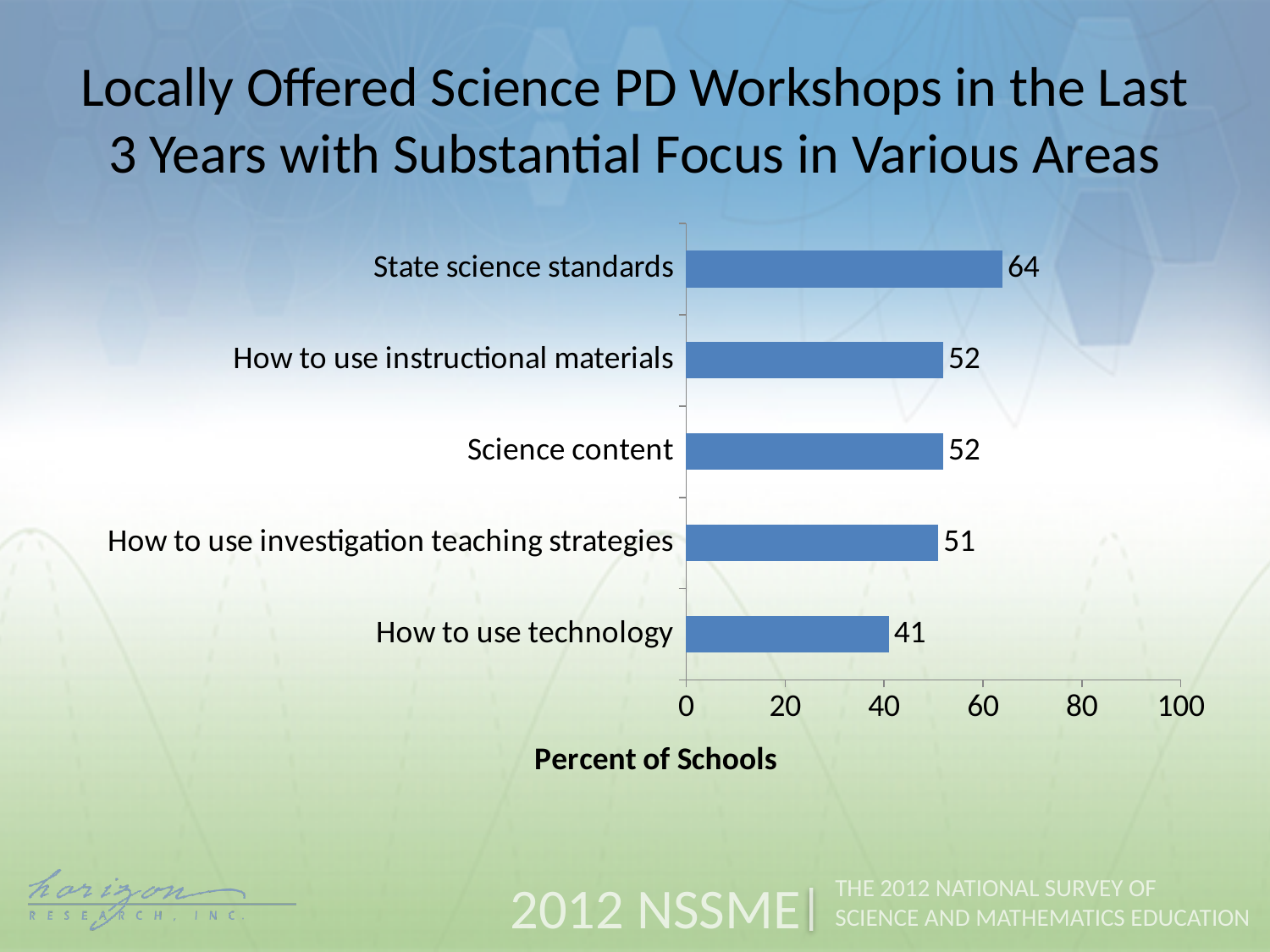
Which is larger, the value for State science standards or the value for Science content? State science standards What is the difference between the values for How to use instructional materials and How to use investigation teaching strategies? 1 What is the value for How to use investigation teaching strategies? 51 Which category has the lowest value? How to use technology What kind of chart is shown on the slide? Bar chart Which category has the highest value? State science standards What is the difference between the values for State science standards and How to use technology? 23 What is the value for How to use technology? 41 What is the value for State science standards? 64 How many categories are shown in the chart? 5 What is the label of the horizontal axis? Percent of Schools What is the value for Science content? 52